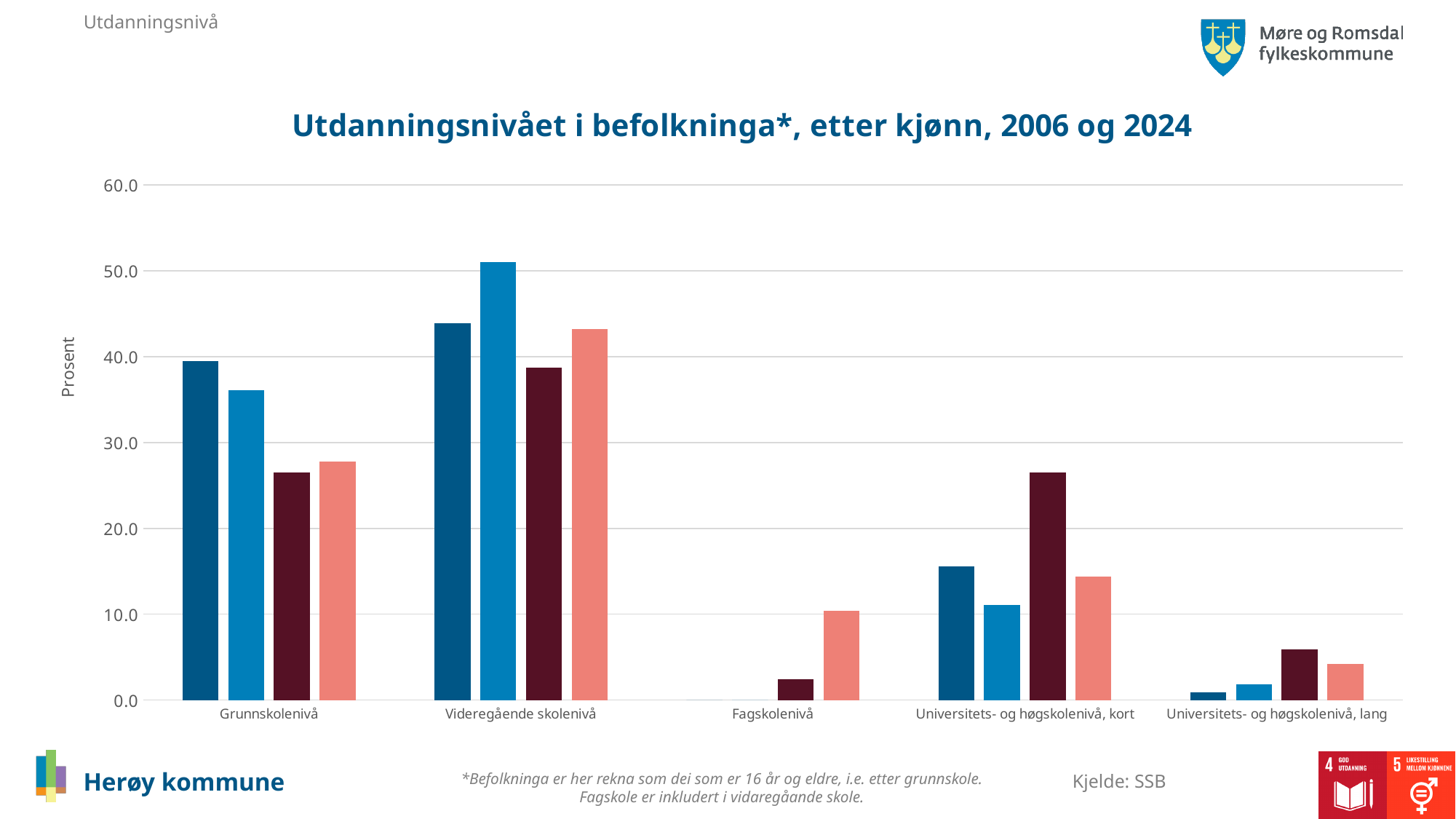
What kind of chart is shown on the slide? bar chart For Grunnskolenivå, which is taller: the dark blue bar or the salmon bar? the dark blue bar Is the light blue bar for Videregående skolenivå greater or less than 40? greater What is the label on the y axis? Prosent Is the dark maroon bar for Universitets- og høgskolenivå, kort greater or less than 20? greater Is the dark blue bar for Grunnskolenivå greater or less than 30? greater Which category has the lowest bars overall? Universitets- og høgskolenivå, lang How many education-level categories are shown on the x axis? 5 What is the title of the chart? Utdanningsnivået i befolkninga*, etter kjønn, 2006 og 2024 Which category has the tallest bar in the chart? Videregående skolenivå How many bars are visible for the Fagskolenivå category? 2